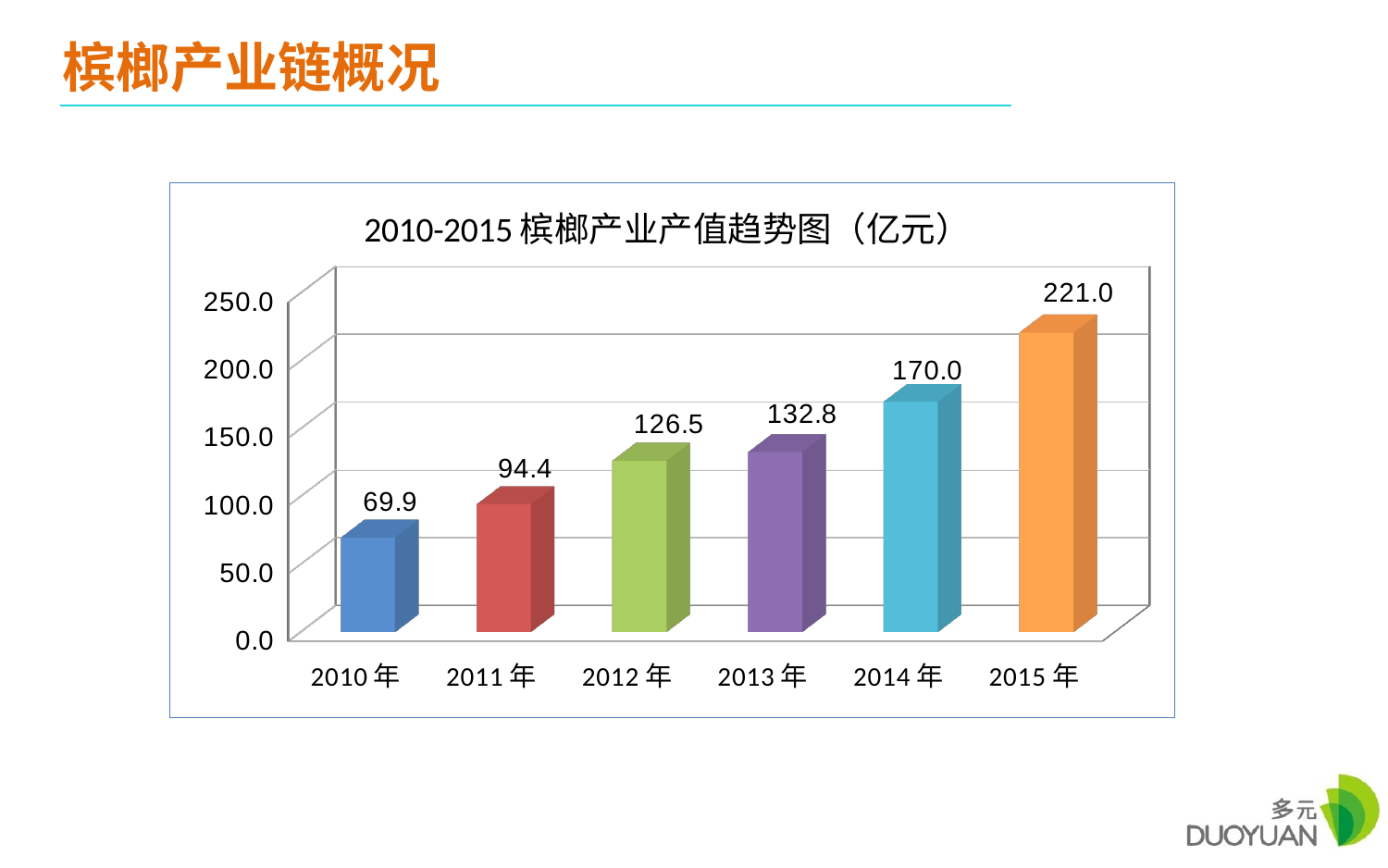
Is the value for 2014年 greater or less than 150.0? greater What is the value for 2015年? 221.0 Which year has the lowest value? 2010年 What is the difference between the values for 2015年 and 2014年? 51.0 What is the value for 2010年? 69.9 Which is larger, the value for 2012年 or the value for 2013年? 2013年 How many years are shown on the x axis? 6 Which year has the highest value? 2015年 Do the values rise or fall from 2010年 to 2015年? rise What is the difference between the values for 2012年 and 2011年? 32.1 What kind of chart is shown on the slide? bar chart What is the value for 2013年? 132.8